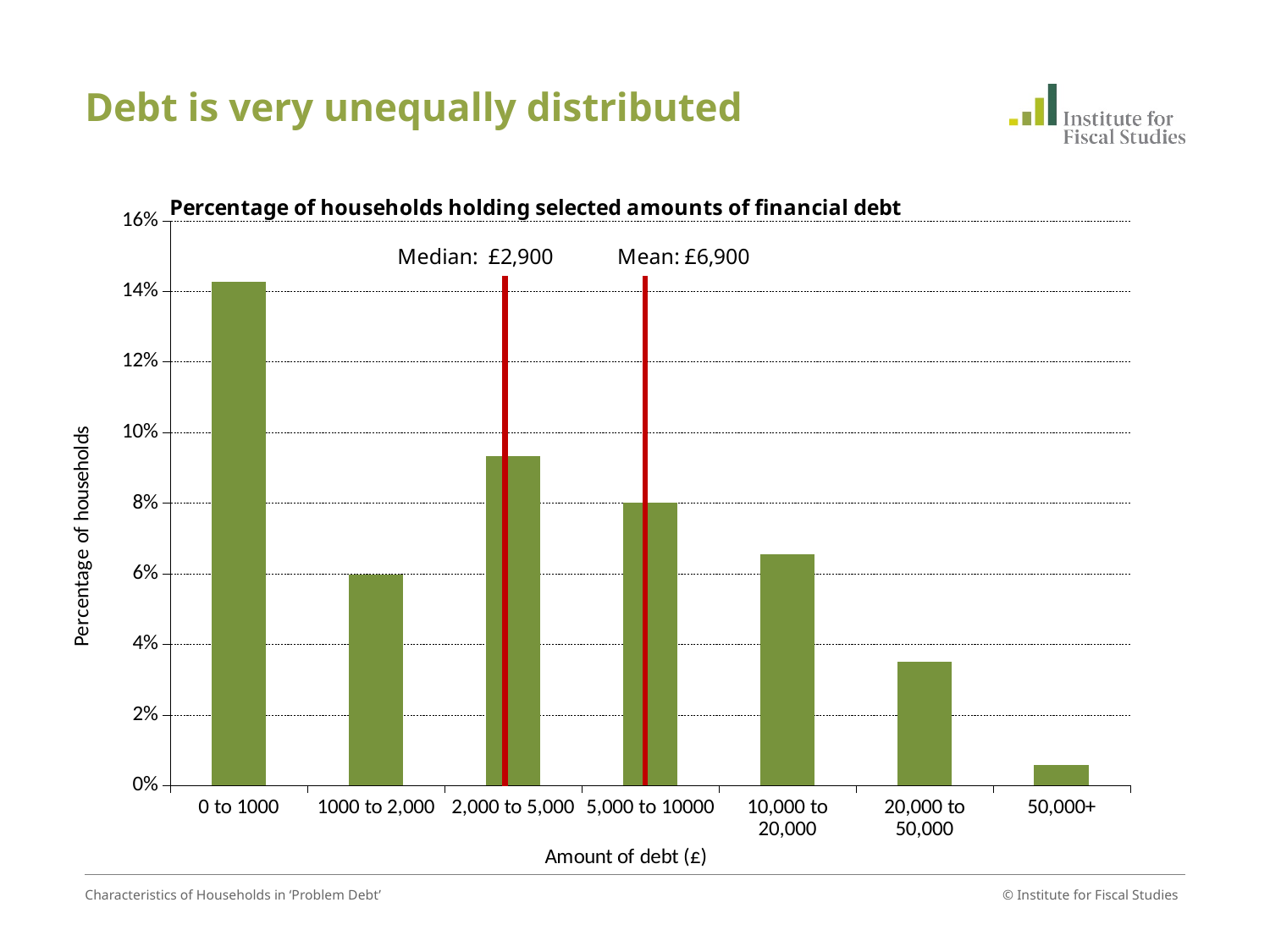
How many debt categories are shown on the x axis? 7 Which has a higher percentage of households: 2,000 to 5,000 or 1000 to 2,000? 2,000 to 5,000 Which debt category has the lowest percentage of households? 50,000+ Is the value for 0 to 1000 greater or less than 12%? greater What median amount of debt is marked on the chart? £2,900 What kind of chart is shown on the slide? bar chart Is the value for 20,000 to 50,000 greater or less than 4%? less Is the value for 2,000 to 5,000 greater or less than 8%? greater Which debt category has the highest percentage of households? 0 to 1000 Do the values rise or fall across the categories from 5,000 to 10000 through 50,000+? fall